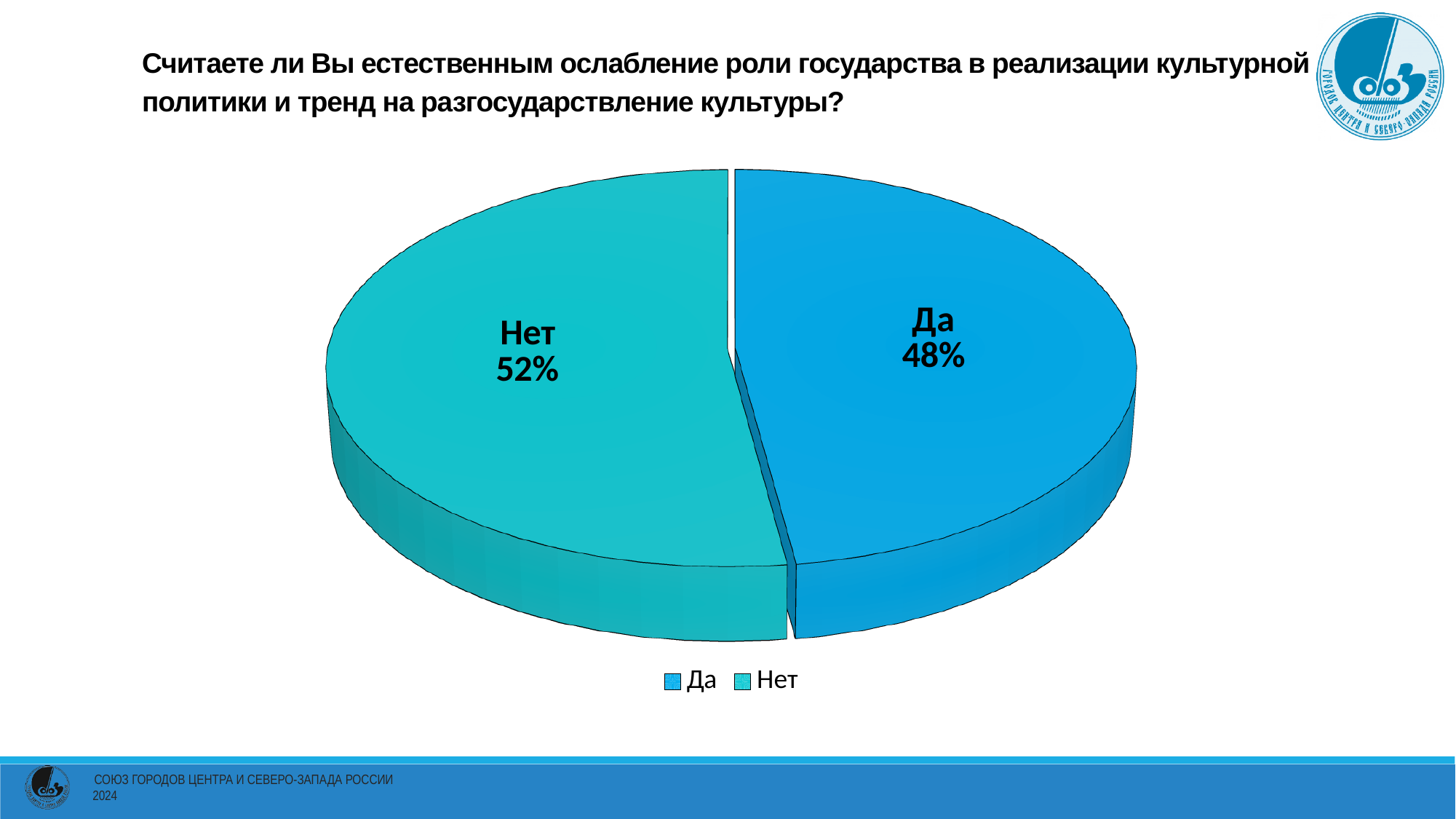
Which legend entry is shown in the darker blue colour? Да What kind of chart is shown on the slide? Pie chart What is the difference in percentage points between the "Нет" and "Да" slices? 4% What share of the pie does the "Нет" slice represent? 52% Is the value for "Да" greater or less than 50%? less What is the total of the two slices shown in the pie chart? 100% Which slice is the smallest in the pie chart? Да Which slice is the largest in the pie chart? Нет How many entries does the legend list? 2 How many slices does the pie chart have? 2 What share of the pie does the "Да" slice represent? 48% Which is larger, the "Да" slice or the "Нет" slice? Нет